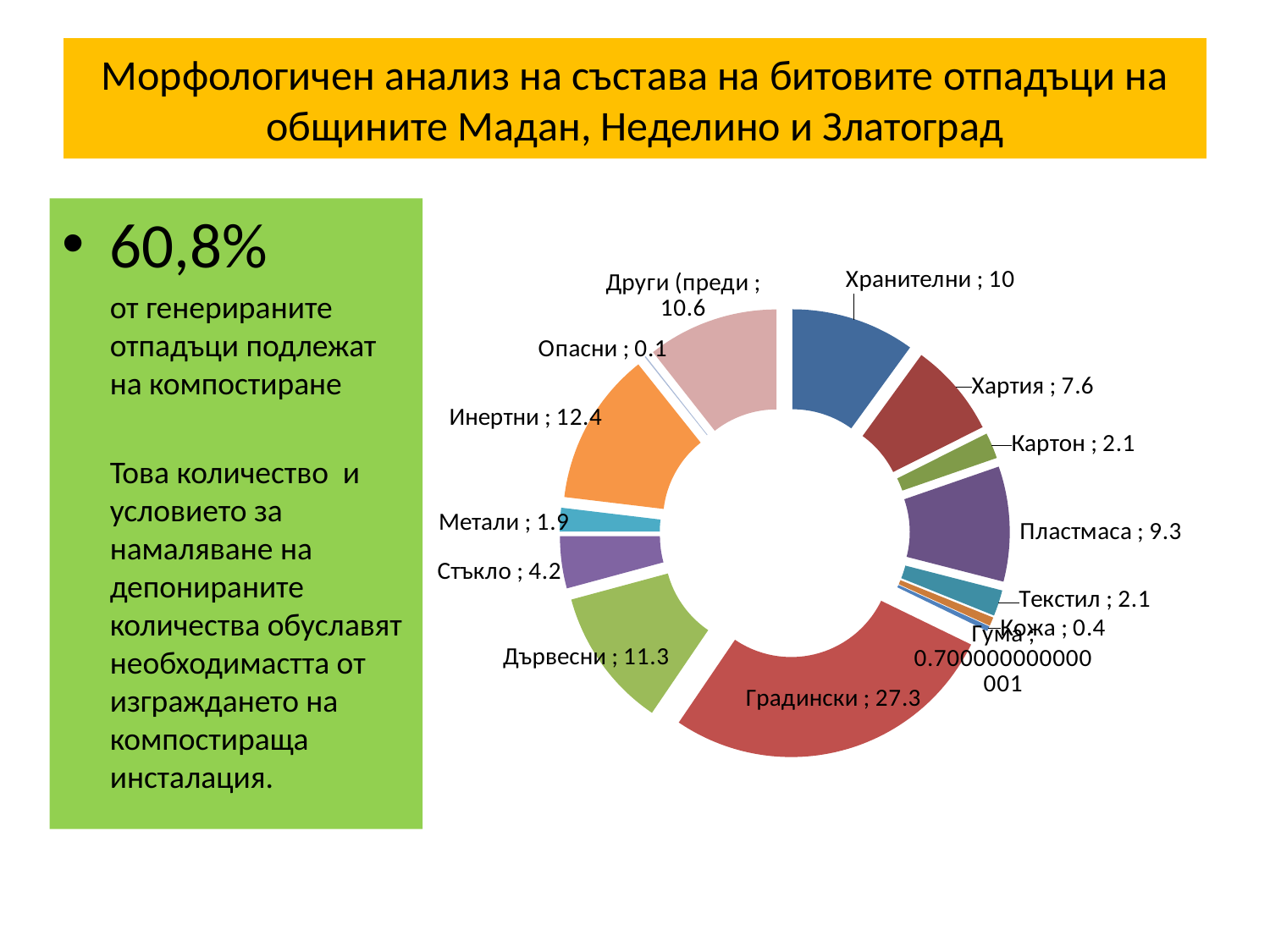
Which is larger, the value for Стъкло or the value for Метали? Стъкло Which category has the largest value? Градински What is the value for Градински? 27.3 How many categories are shown in the chart? 14 Which is larger, the value for Инертни or the value for Дървесни? Инертни What is the difference between the values for Градински and Дървесни? 16 Which category has the smallest value? Опасни What type of chart is shown on the slide? Doughnut (pie) chart What is the difference between the values for Хранителни and Хартия? 2.4 What is the value for Пластмаса? 9.3 What is the value for Инертни? 12.4 What is the value for Хартия? 7.6